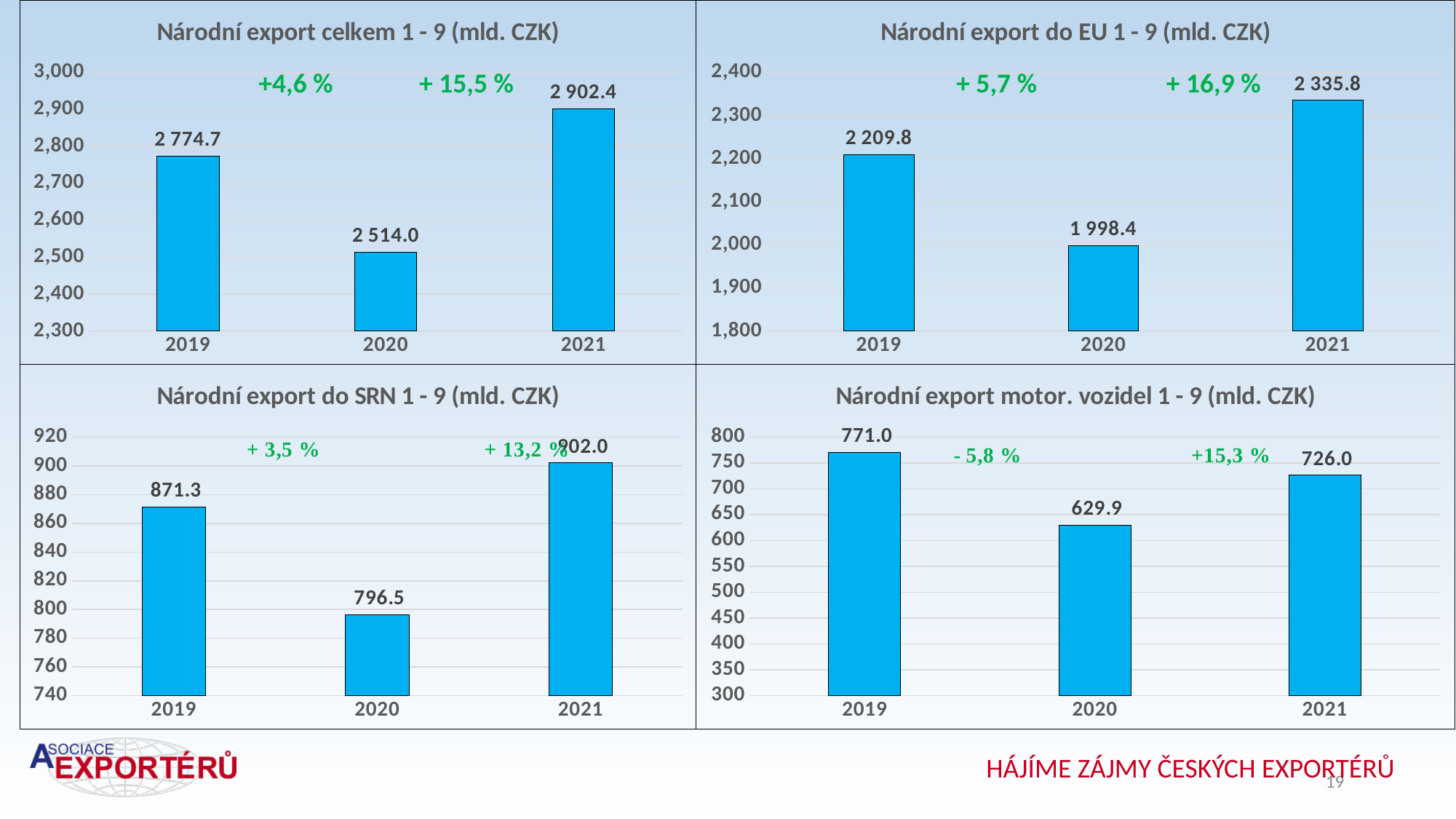
How many years are shown in the chart 'Národní export motor. vozidel 1 - 9 (mld. CZK)'? 3 In the chart 'Národní export motor. vozidel 1 - 9 (mld. CZK)', which is larger, the value for 2019 or the value for 2021? 2019 In the chart 'Národní export celkem 1 - 9 (mld. CZK)', what is the difference between the 2021 and 2019 values? 127.7 In the chart 'Národní export do EU 1 - 9 (mld. CZK)', what is the value for 2021? 2 335.8 In the chart 'Národní export celkem 1 - 9 (mld. CZK)', what is the value for 2020? 2 514.0 In the chart 'Národní export do SRN 1 - 9 (mld. CZK)', what is the value for 2019? 871.3 In the chart 'Národní export do EU 1 - 9 (mld. CZK)', is the value for 2020 greater or less than 2,000? less In the chart 'Národní export celkem 1 - 9 (mld. CZK)', which year has the highest value? 2021 In the chart 'Národní export do EU 1 - 9 (mld. CZK)', which year has the lowest value? 2020 In the chart 'Národní export do SRN 1 - 9 (mld. CZK)', what is the difference between the 2021 and 2020 values? 105.5 What type of chart is 'Národní export do SRN 1 - 9 (mld. CZK)'? bar chart In the chart 'Národní export motor. vozidel 1 - 9 (mld. CZK)', which year has the highest value? 2019